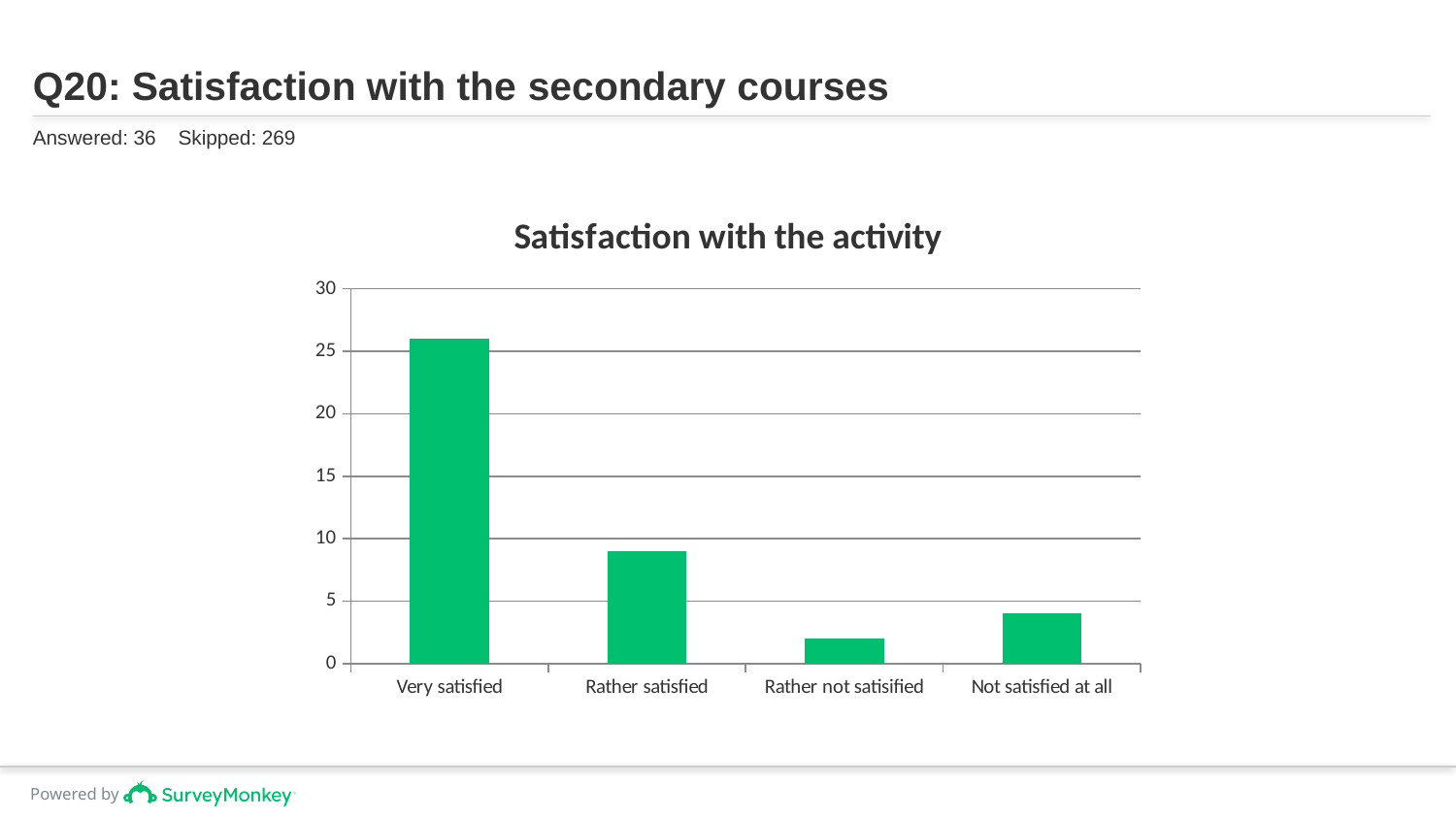
Is the value for Not satisfied at all greater or less than 5? less Is the value for Rather satisfied greater or less than 10? less Which category has the highest value in the chart? Very satisfied Which is larger, the value for Rather satisfied or the value for Not satisfied at all? Rather satisfied What colour are the bars in the chart? green What is the title of the chart? Satisfaction with the activity Which category has the lowest value in the chart? Rather not satisified How many categories are shown on the x axis of the chart? 4 Is the value for Very satisfied greater or less than 25? greater What kind of chart is shown on the slide? bar chart Which is larger, the value for Not satisfied at all or the value for Rather not satisified? Not satisfied at all